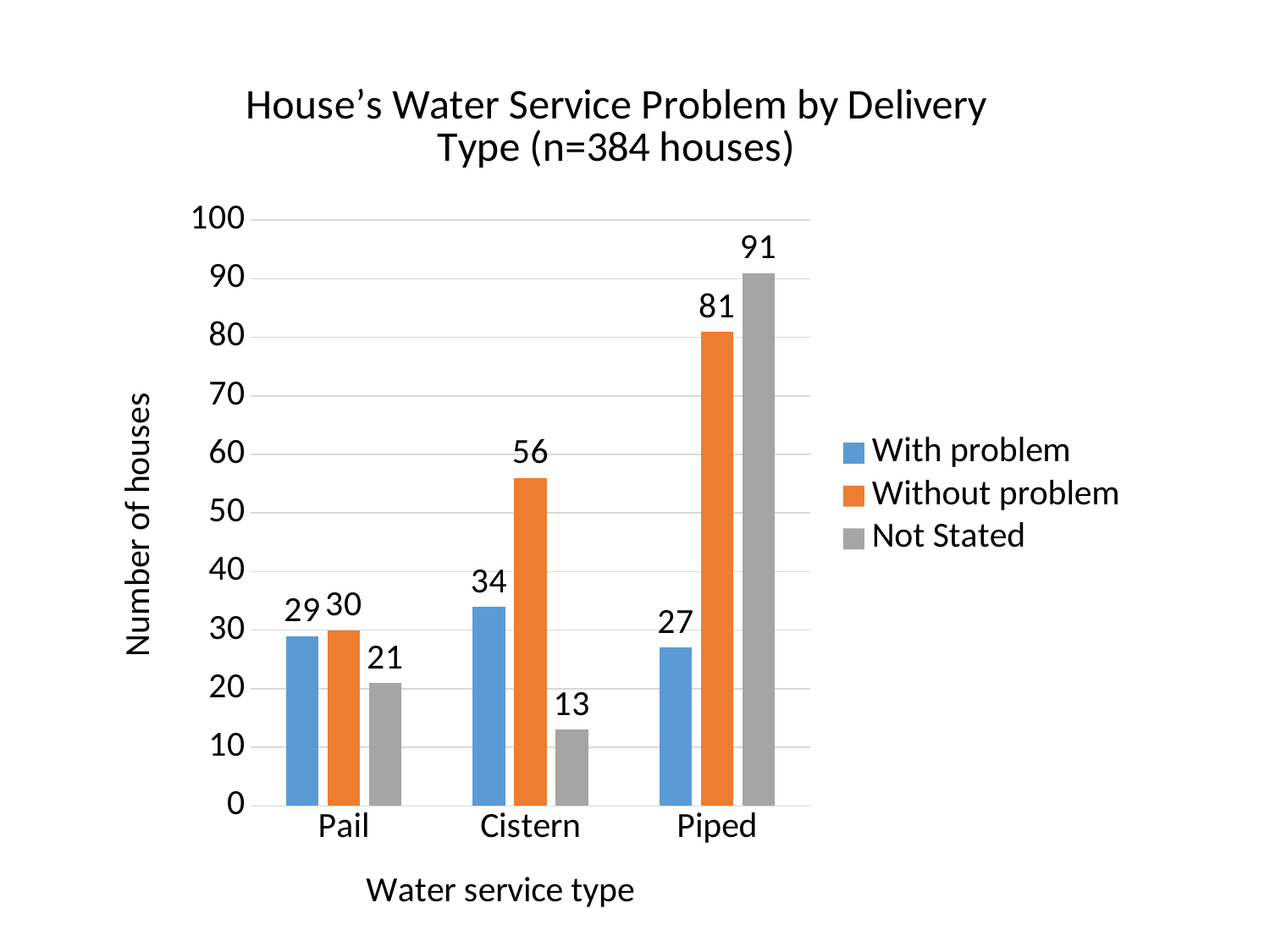
What is the value for Not Stated in the Piped category? 91 Which water service type has the highest Not Stated value? Piped What is the difference between Without problem and With problem for Piped? 54 Is the Without problem value for Piped greater or less than 70? greater How many series does the legend list? 3 Which is larger for Cistern: With problem or Not Stated? With problem How many water service types are shown on the x axis? 3 How many Cistern houses are without a problem? 56 Which water service type has the lowest Not Stated value? Cistern What kind of chart is shown? bar chart How many houses with a problem use Pail water service? 29 What is the title of the chart? House's Water Service Problem by Delivery Type (n=384 houses)